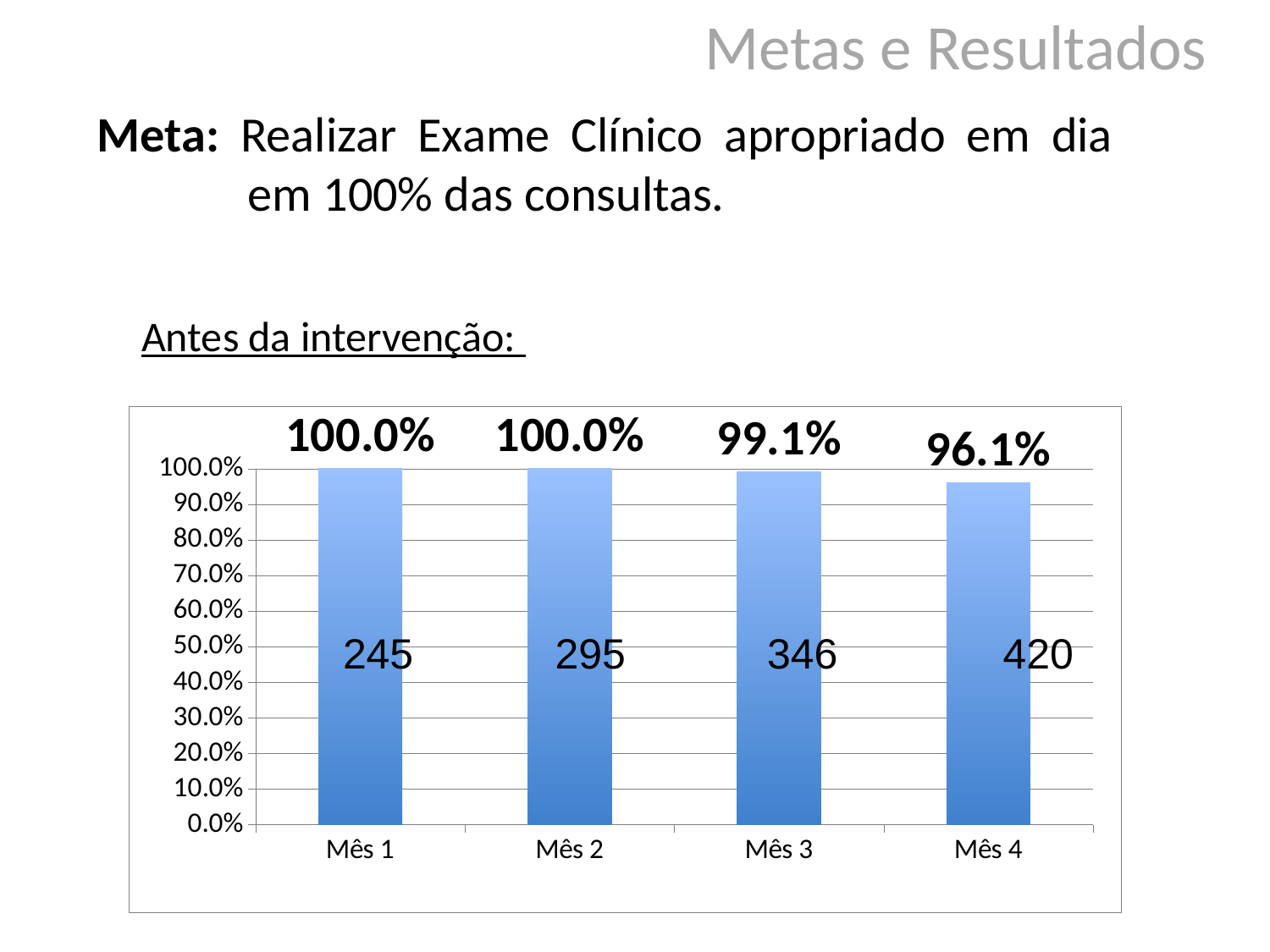
What is the heading written directly above the chart? Antes da intervenção: What number is printed inside the bar for Mês 4? 420 Do the percentage values rise or fall from Mês 1 to Mês 4? Fall What is the difference between the percentage values for Mês 1 and Mês 4? 3.9% What kind of chart is shown on the slide? Bar chart How many months (categories) are shown on the chart? 4 Which month has the lowest percentage value? Mês 4 What is the percentage value shown for Mês 3? 99.1% What number is printed inside the bar for Mês 2? 295 Which has a higher percentage value, Mês 3 or Mês 4? Mês 3 What is the difference between the percentage values for Mês 3 and Mês 4? 3.0% What is the percentage value shown for Mês 4? 96.1%